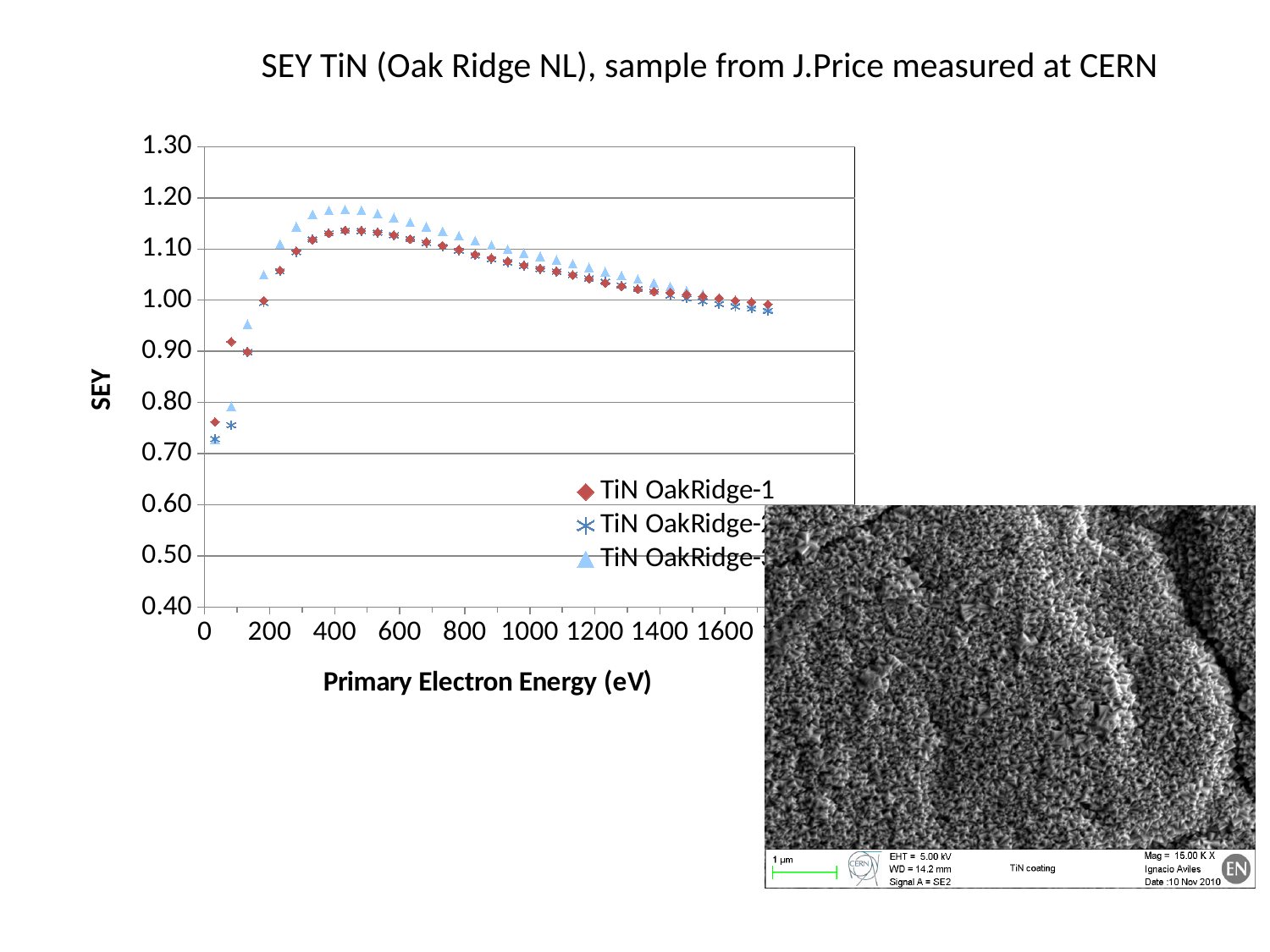
Is the first (lowest-energy) SEY value for TiN OakRidge-1 greater or less than 0.80? less What is the title of the chart? SEY TiN (Oak Ridge NL), sample from J.Price measured at CERN Is the peak SEY value of the light blue triangle series greater or less than 1.10? greater Do the SEY values for TiN OakRidge-1 rise or fall as the primary electron energy increases from 0 to 400 eV? rise Is the SEY value for TiN OakRidge-1 at 1000 eV greater or less than 1.10? less How many series does the chart legend list? 3 What kind of chart is shown on the slide? scatter chart Do the SEY values for TiN OakRidge-1 rise or fall as the primary electron energy increases from 600 eV to 1600 eV? fall What is the x-axis title of the chart? Primary Electron Energy (eV) Which series reaches the higher peak SEY, the red diamonds (TiN OakRidge-1) or the light blue triangles? light blue triangles